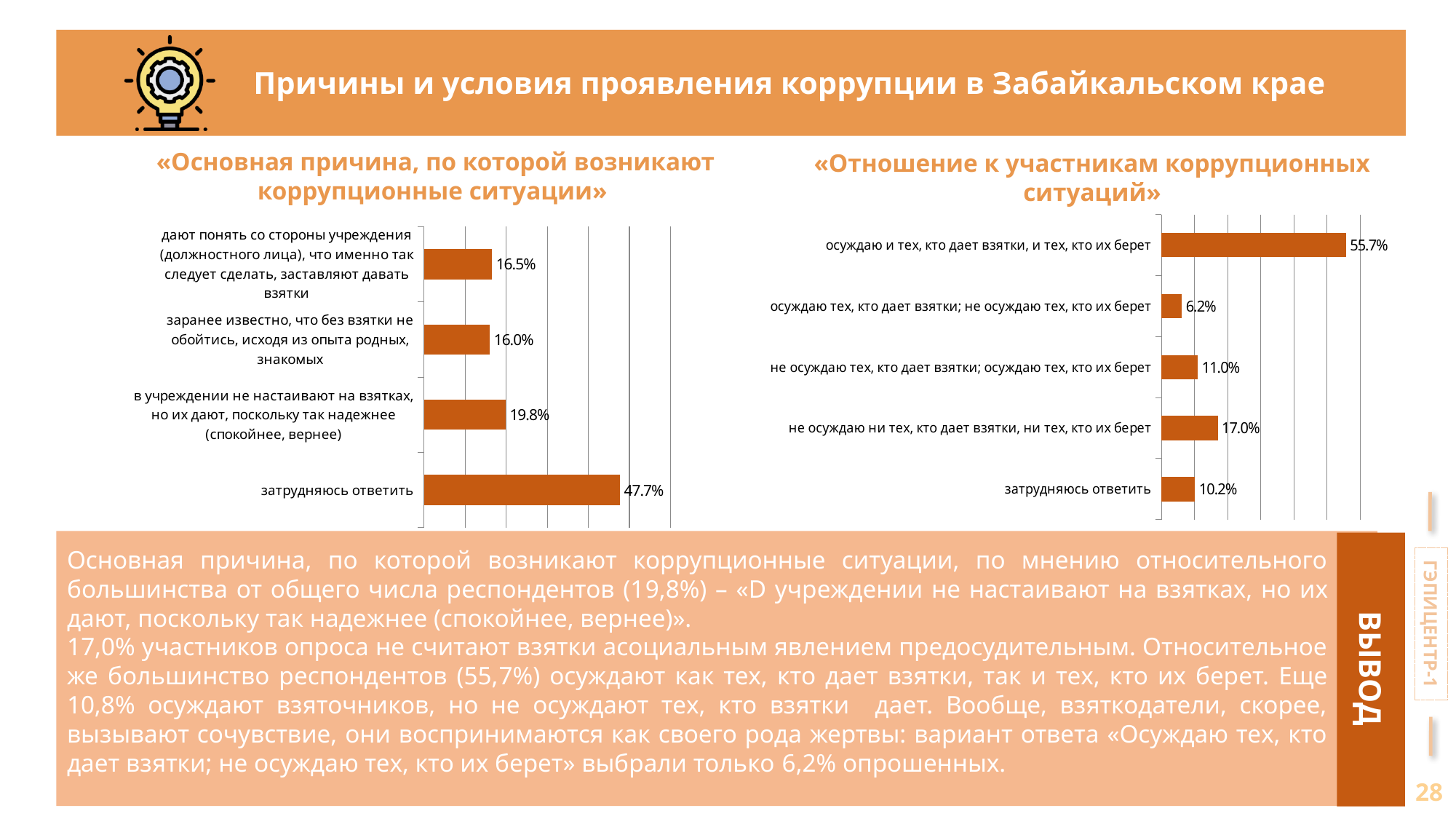
In the chart «Основная причина, по которой возникают коррупционные ситуации», what is the value for «в учреждении не настаивают на взятках, но их дают, поскольку так надежнее (спокойнее, вернее)»? 19.8% In the chart «Отношение к участникам коррупционных ситуаций», what is the value for «не осуждаю ни тех, кто дает взятки, ни тех, кто их берет»? 17.0% How many categories are shown in the chart «Основная причина, по которой возникают коррупционные ситуации»? 4 In the chart «Основная причина, по которой возникают коррупционные ситуации», which category has the lowest value? заранее известно, что без взятки не обойтись, исходя из опыта родных, знакомых In the chart «Отношение к участникам коррупционных ситуаций», which is larger: «не осуждаю тех, кто дает взятки; осуждаю тех, кто их берет» or «затрудняюсь ответить»? не осуждаю тех, кто дает взятки; осуждаю тех, кто их берет How many categories are shown in the chart «Отношение к участникам коррупционных ситуаций»? 5 In the chart «Отношение к участникам коррупционных ситуаций», what is the value for «осуждаю и тех, кто дает взятки, и тех, кто их берет»? 55.7% In the chart «Отношение к участникам коррупционных ситуаций», which category has the lowest value? осуждаю тех, кто дает взятки; не осуждаю тех, кто их берет In the chart «Основная причина, по которой возникают коррупционные ситуации», what is the difference between «затрудняюсь ответить» and «в учреждении не настаивают на взятках, но их дают, поскольку так надежнее (спокойнее, вернее)»? 27.9% In the chart «Отношение к участникам коррупционных ситуаций», what is the difference between «не осуждаю ни тех, кто дает взятки, ни тех, кто их берет» and «осуждаю тех, кто дает взятки; не осуждаю тех, кто их берет»? 10.8% What type of chart is «Отношение к участникам коррупционных ситуаций»? bar chart In the chart «Основная причина, по которой возникают коррупционные ситуации», what is the value for «затрудняюсь ответить»? 47.7%